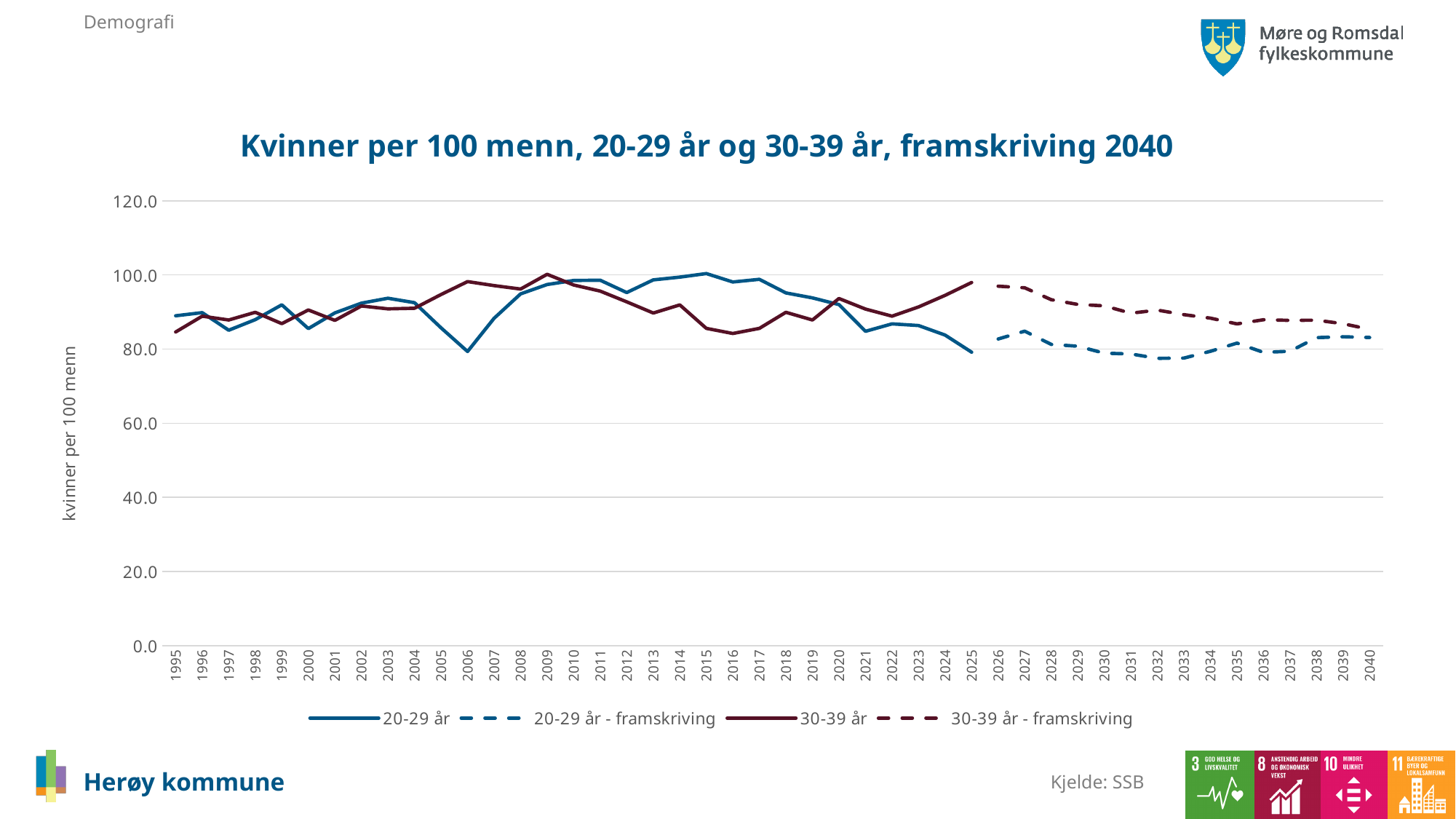
In 2016, which series has the higher value, 20-29 år or 30-39 år? 20-29 år What is the label on the vertical axis? kvinner per 100 menn Is the value for 20-29 år - framskriving in 2032 greater or less than 80? less In 2006, which series has the higher value, 20-29 år or 30-39 år? 30-39 år Is the value for 20-29 år in 2013 greater or less than 80? greater Does the 20-29 år - framskriving series rise or fall from 2027 to 2032? fall How many series does the legend list? 4 Is the value for 30-39 år - framskriving in 2026 greater or less than 80? greater In 2032, which projected series is higher, 20-29 år - framskriving or 30-39 år - framskriving? 30-39 år - framskriving What kind of chart is shown on the slide? line chart What is the title of the chart? Kvinner per 100 menn, 20-29 år og 30-39 år, framskriving 2040